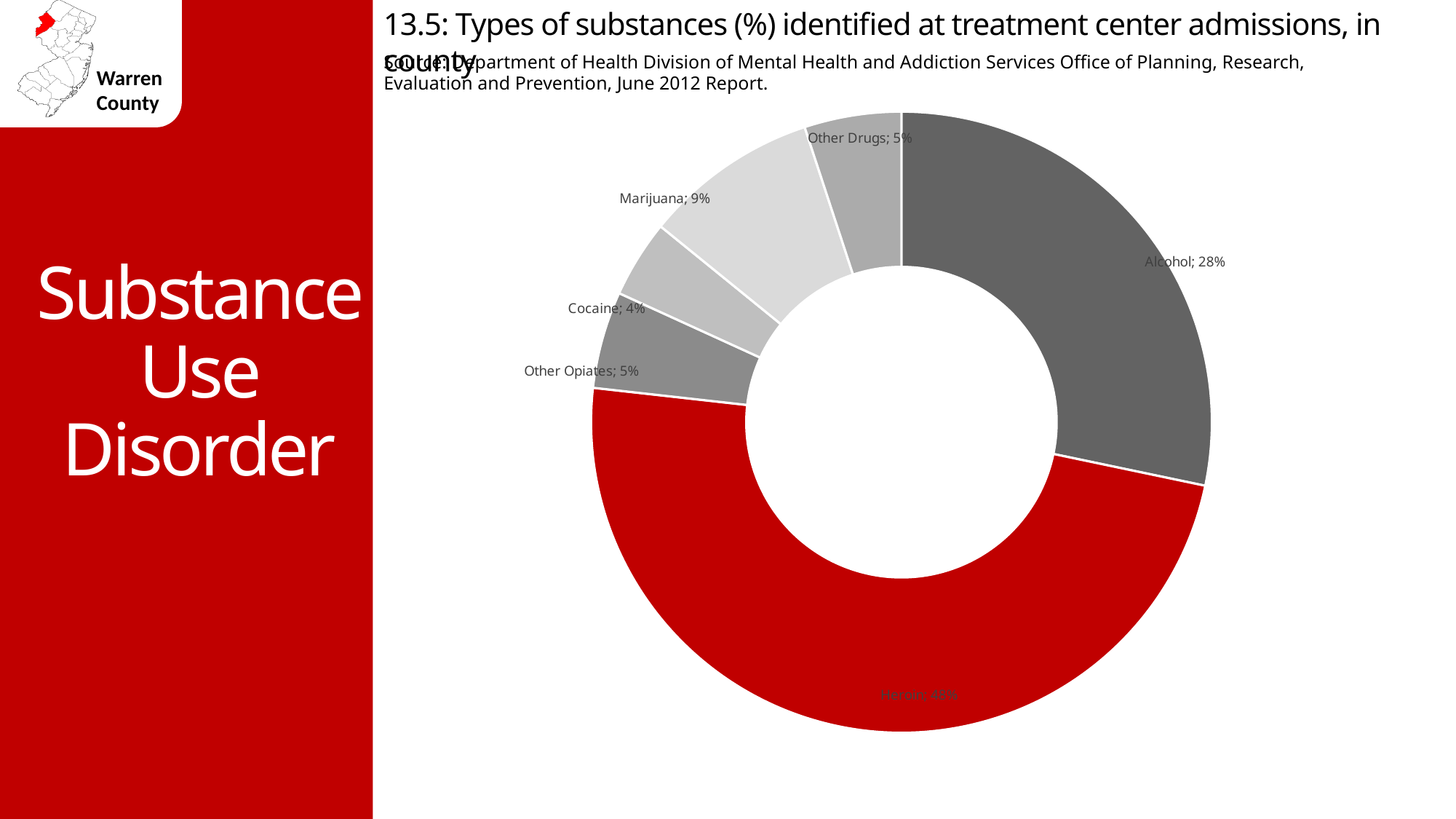
What is the combined share of Other Opiates and Other Drugs? 10% How many substance categories are shown in the chart? 6 What kind of chart is shown on the slide? Pie chart (doughnut) What percentage of treatment center admissions identified Alcohol? 28% What is the difference in percentage points between Heroin and Alcohol? 20 Which slice of the chart is coloured red? Heroin Which substance has the smallest share of treatment center admissions? Cocaine Which has a larger share, Marijuana or Other Opiates? Marijuana What percentage of treatment center admissions identified Heroin? 48% What percentage of treatment center admissions identified Cocaine? 4% What percentage of treatment center admissions identified Marijuana? 9% Which substance has the largest share of treatment center admissions? Heroin